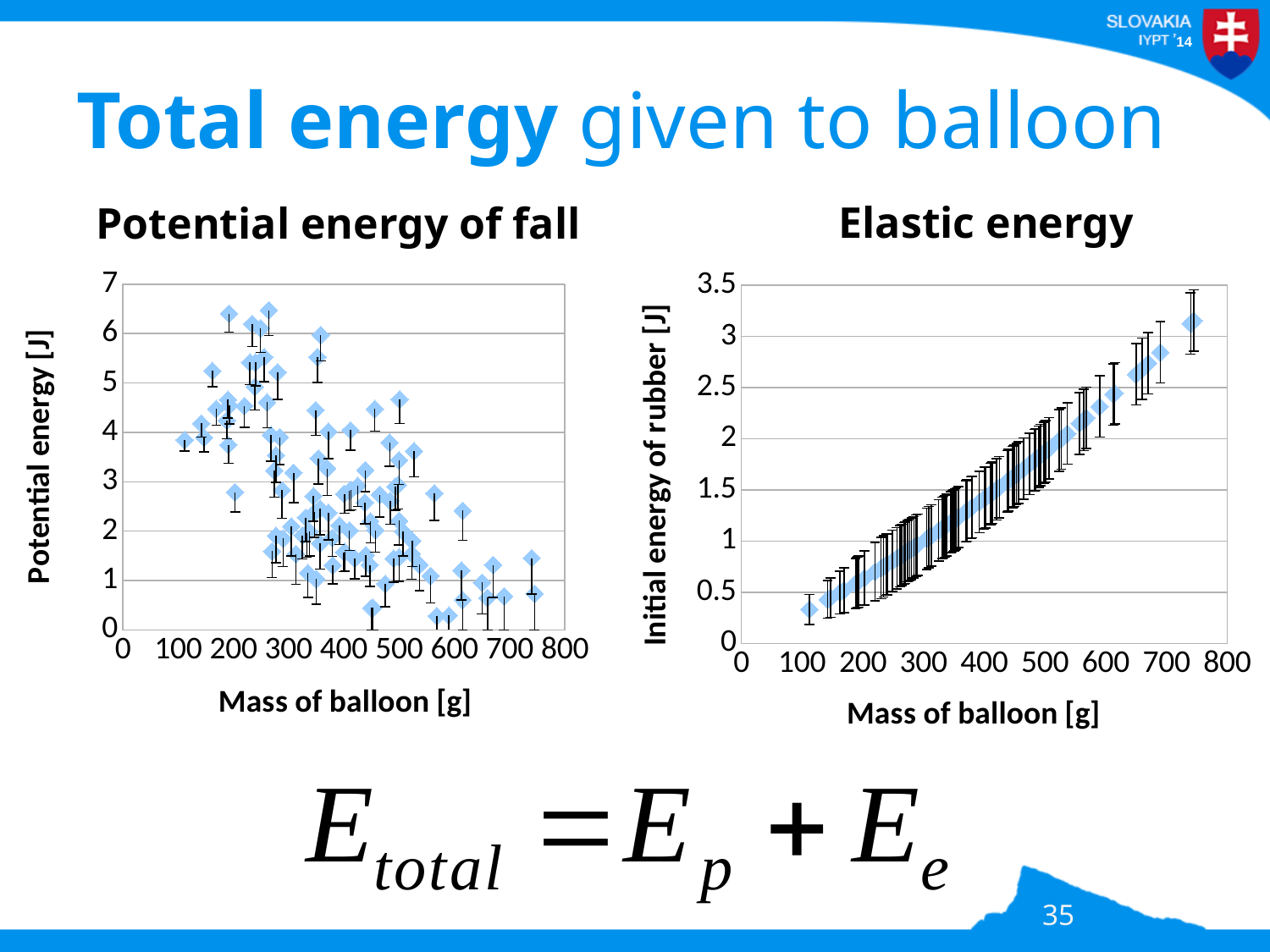
What kind of chart is the 'Elastic energy' chart? Scatter chart In the 'Potential energy of fall' chart, do the values generally rise or fall as the mass of the balloon increases? Fall What is the x-axis title of the 'Potential energy of fall' chart? Mass of balloon [g] What kind of chart is the 'Potential energy of fall' chart? Scatter chart What is the y-axis title of the 'Elastic energy' chart? Initial energy of rubber [J] In the 'Elastic energy' chart, is the value for the lightest balloon (around 100 g) greater or less than 0.5? less In the 'Potential energy of fall' chart, is the lowest plotted value greater or less than 1? less In the 'Elastic energy' chart, do the values rise or fall as the mass of the balloon increases? Rise In the 'Potential energy of fall' chart, is the highest plotted value greater or less than 6? greater